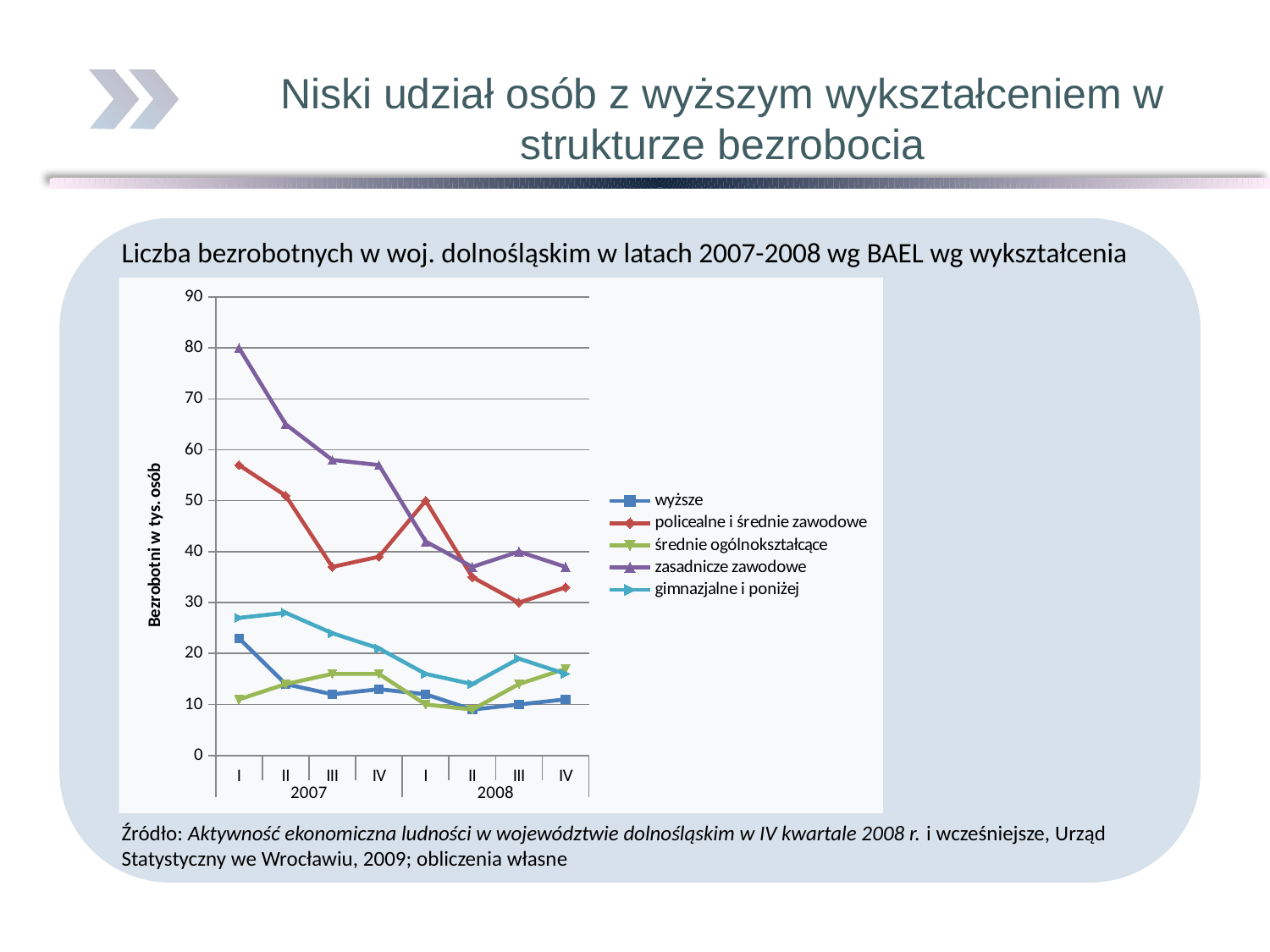
How many quarterly points are plotted along the x axis for each series? 8 What is the title of the chart? Liczba bezrobotnych w woj. dolnośląskim w latach 2007-2008 wg BAEL wg wykształcenia Does the zasadnicze zawodowe series rise or fall across the four quarters of 2007? fall Which series has the highest value in quarter I of 2007? zasadnicze zawodowe What is the label of the vertical axis? Bezrobotni w tys. osób Is the value for gimnazjalne i poniżej in quarter II of 2007 greater or less than 20? greater Which series has the lowest value in quarter I of 2007? średnie ogólnokształcące In quarter I of 2008, which is larger: policealne i średnie zawodowe or zasadnicze zawodowe? policealne i średnie zawodowe Is the value for zasadnicze zawodowe in quarter I of 2007 greater or less than 70? greater How many series does the legend list? 5 Is the value for wyższe in quarter IV of 2008 greater or less than 20? less What kind of chart is shown on the slide? line chart